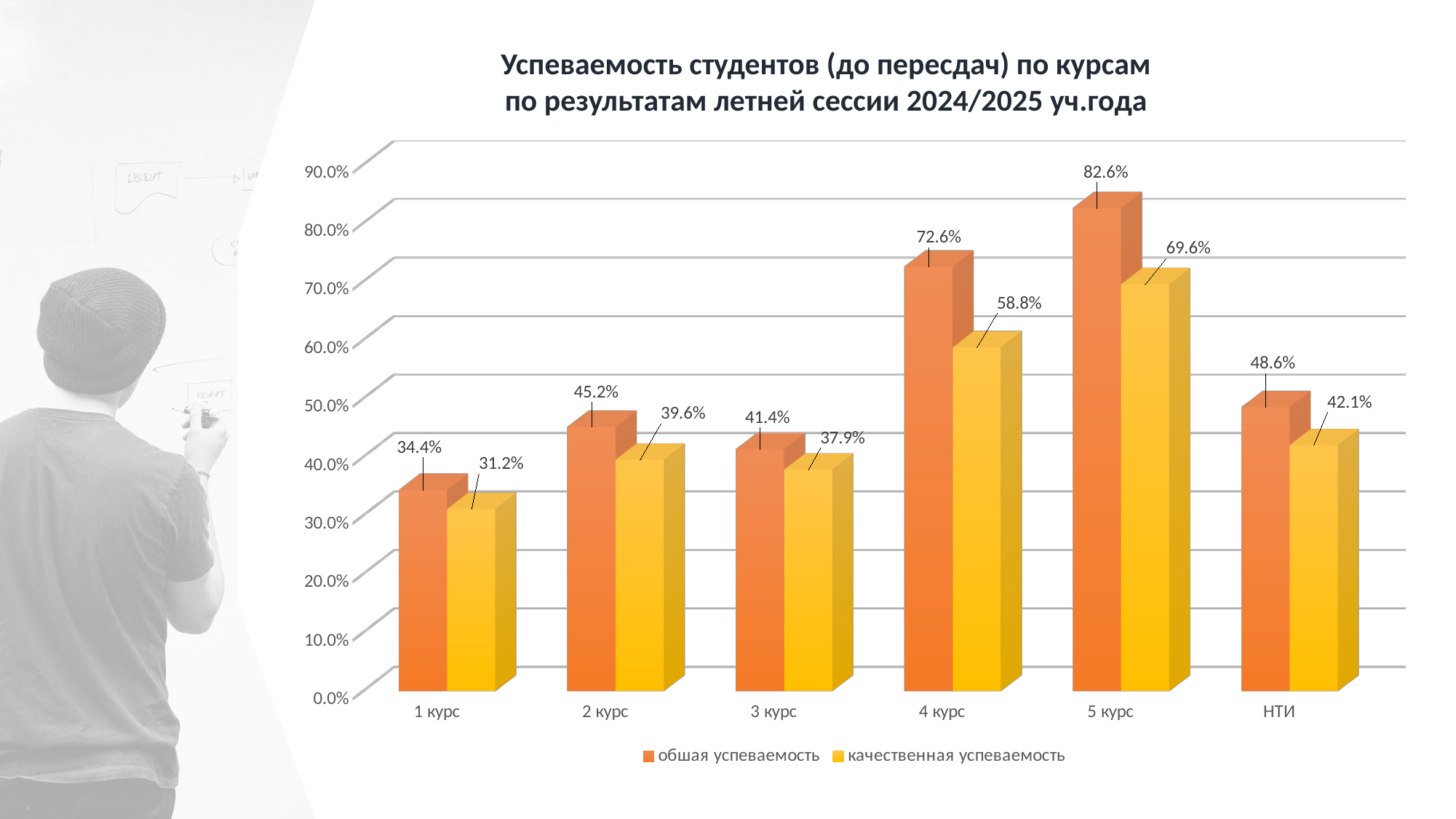
Which is larger: обшая успеваемость for 2 курс or обшая успеваемость for 3 курс? 2 курс What is the difference between обшая успеваемость and качественная успеваемость for 5 курс? 13.0% How many series does the legend list? 2 What is the value of качественная успеваемость for НТИ? 42.1% What is the value of обшая успеваемость for 4 курс? 72.6% What kind of chart is shown on the slide? Bar chart Which category has the highest обшая успеваемость? 5 курс What is the value of качественная успеваемость for 1 курс? 31.2% How many categories are shown on the x axis? 6 Which category has the lowest качественная успеваемость? 1 курс Is the value of качественная успеваемость for 4 курс greater or less than 50.0%? greater Which series is shown in yellow in the legend? качественная успеваемость